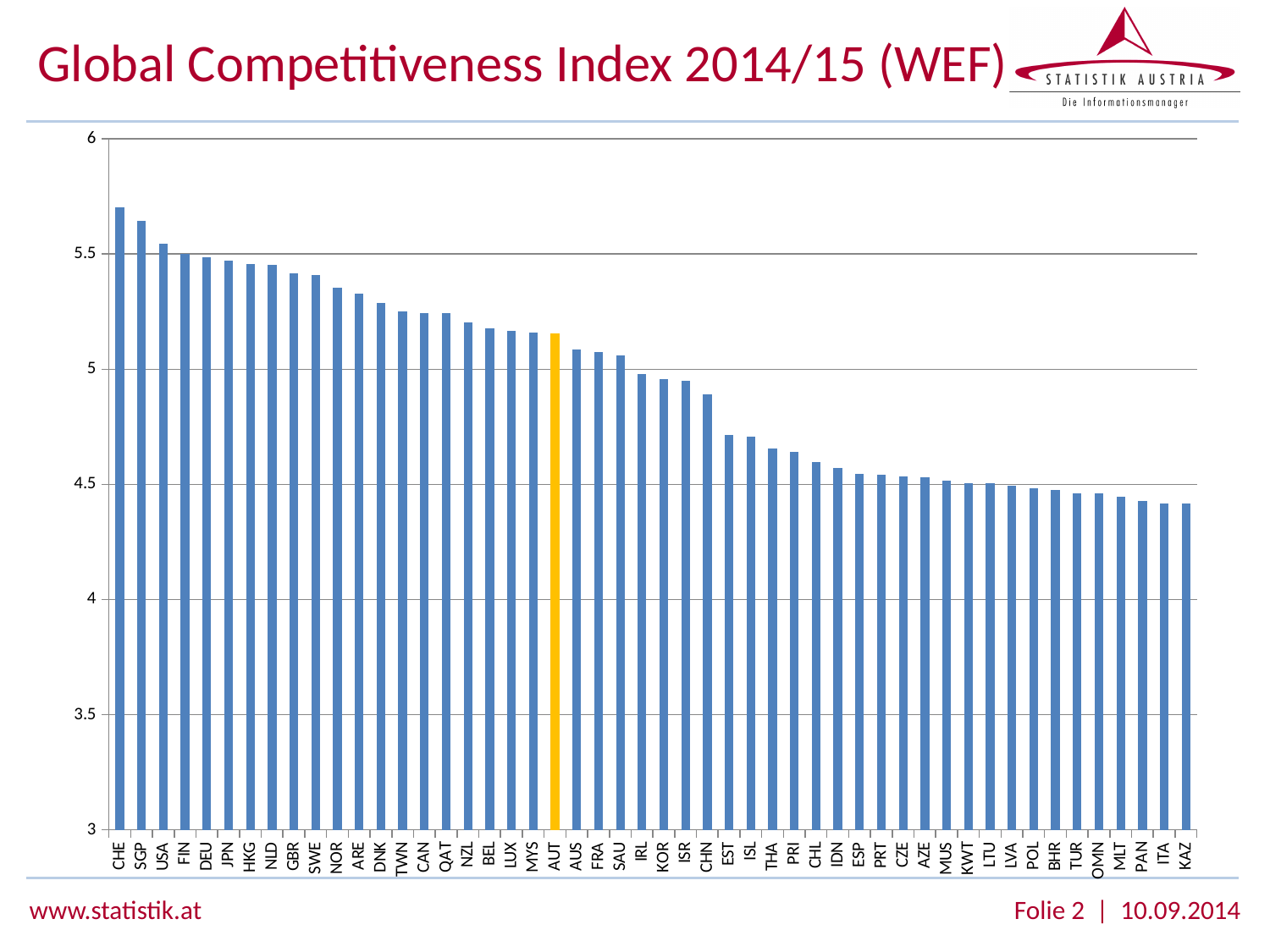
Is the value for NOR greater or less than 5? greater Is the value for CHN greater or less than 5? less Do the values rise or fall from left to right along the x axis? fall Is the value for KAZ greater or less than 4.5? less Which country has the highest Global Competitiveness Index value in the chart? CHE Which country has the lowest Global Competitiveness Index value in the chart? KAZ How many countries are shown in the chart? 50 What kind of chart is shown on the slide? bar chart Which has the larger value, AUT or CHN? AUT Which country's bar is highlighted in a different colour (yellow) from the others? AUT